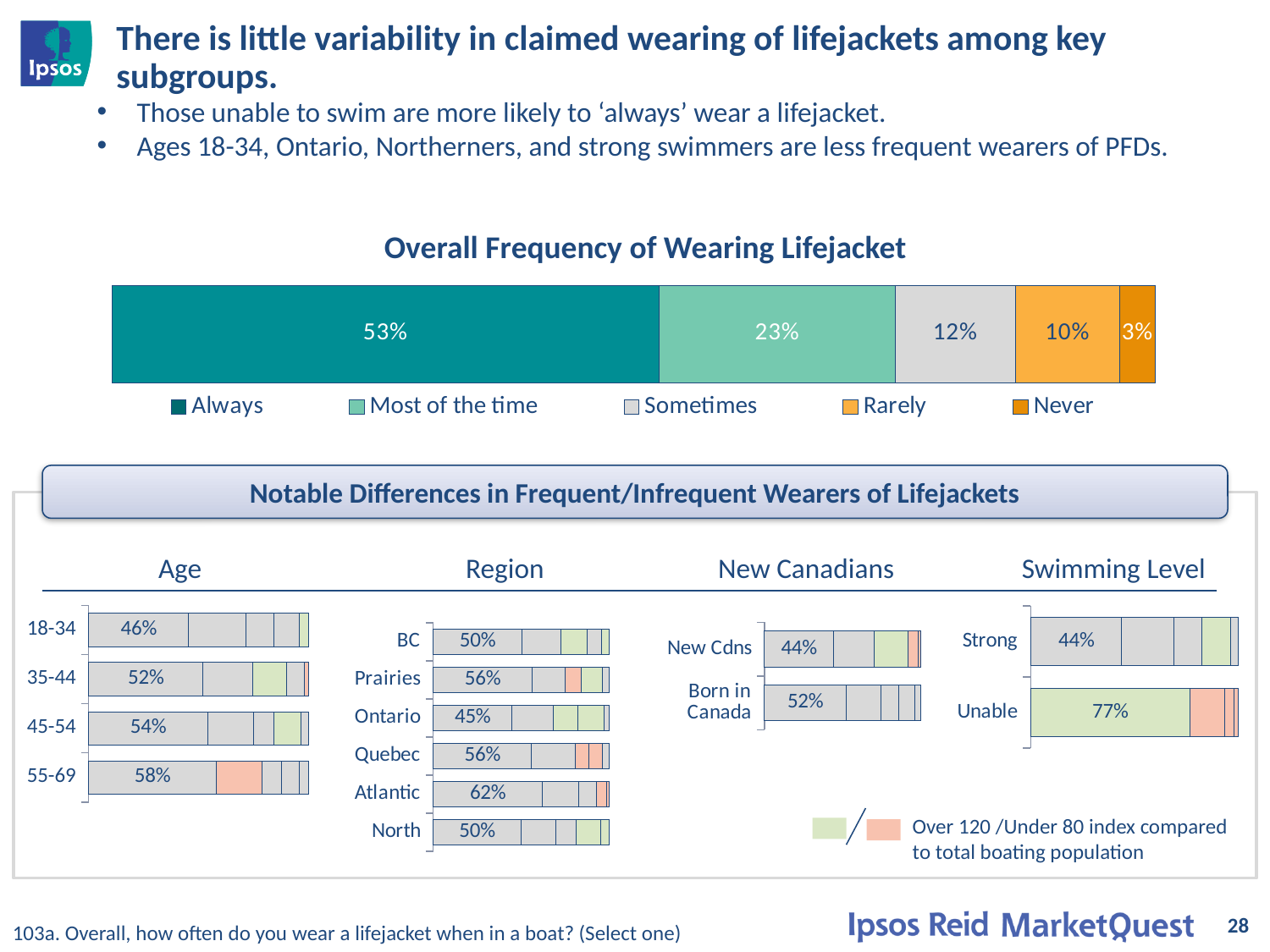
In the 'Overall Frequency of Wearing Lifejacket' chart, how many categories does the legend list? 5 In the 'Age' chart, what percentage is labelled for the 55-69 group? 58% In the 'Overall Frequency of Wearing Lifejacket' chart, what percentage is shown for 'Always'? 53% In the 'Overall Frequency of Wearing Lifejacket' chart, what percentage is shown for 'Most of the time'? 23% In the 'Overall Frequency of Wearing Lifejacket' chart, what percentage is shown for 'Never'? 3% In the 'Swimming Level' chart, what is the difference between the labelled percentages for 'Unable' and 'Strong'? 33% In the 'Age' chart, which age group has the lowest labelled percentage? 18-34 In the 'New Canadians' chart, which group has the larger labelled percentage, 'New Cdns' or 'Born in Canada'? Born in Canada In the 'Overall Frequency of Wearing Lifejacket' chart, what is the difference between the 'Sometimes' and 'Rarely' percentages? 2% In the 'Region' chart, which region has the highest labelled percentage? Atlantic What kind of chart is the 'Overall Frequency of Wearing Lifejacket' chart? Stacked bar chart In the 'Region' chart, what percentage is labelled for Ontario? 45%